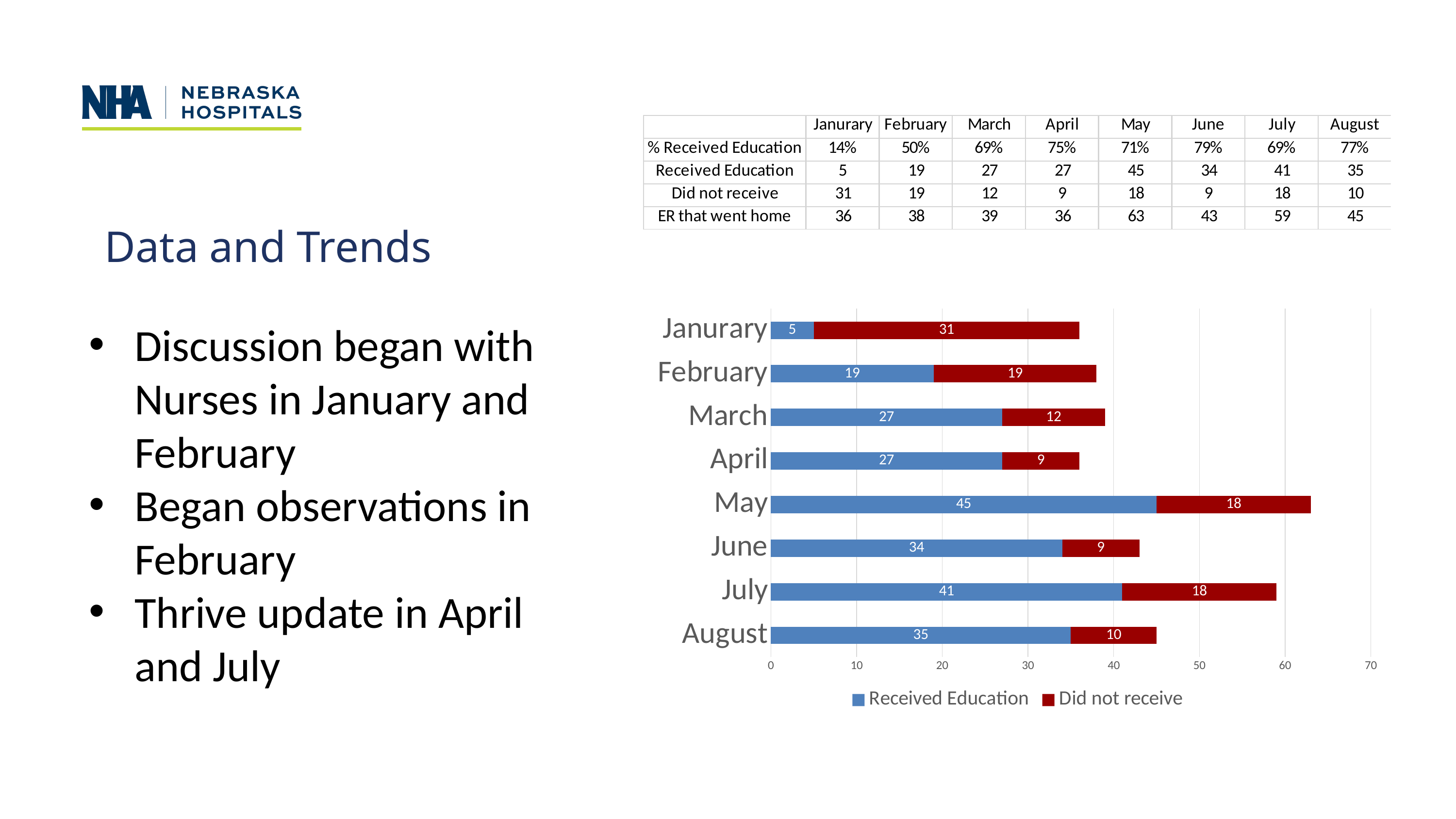
What is the difference between the Received Education values for July and August? 6 What is the total of the stacked bar for May? 63 What is the Received Education value for May? 45 What is the total of the stacked bar for February? 38 Which month has the highest Received Education value? May What is the Did not receive value for January? 31 What kind of chart is shown? Stacked bar chart How many series does the legend list? 2 Which month has the lowest Received Education value? January How many months are shown on the chart? 8 Which colour represents Did not receive in the chart? Red Which is larger, the Did not receive value for March or for April? March